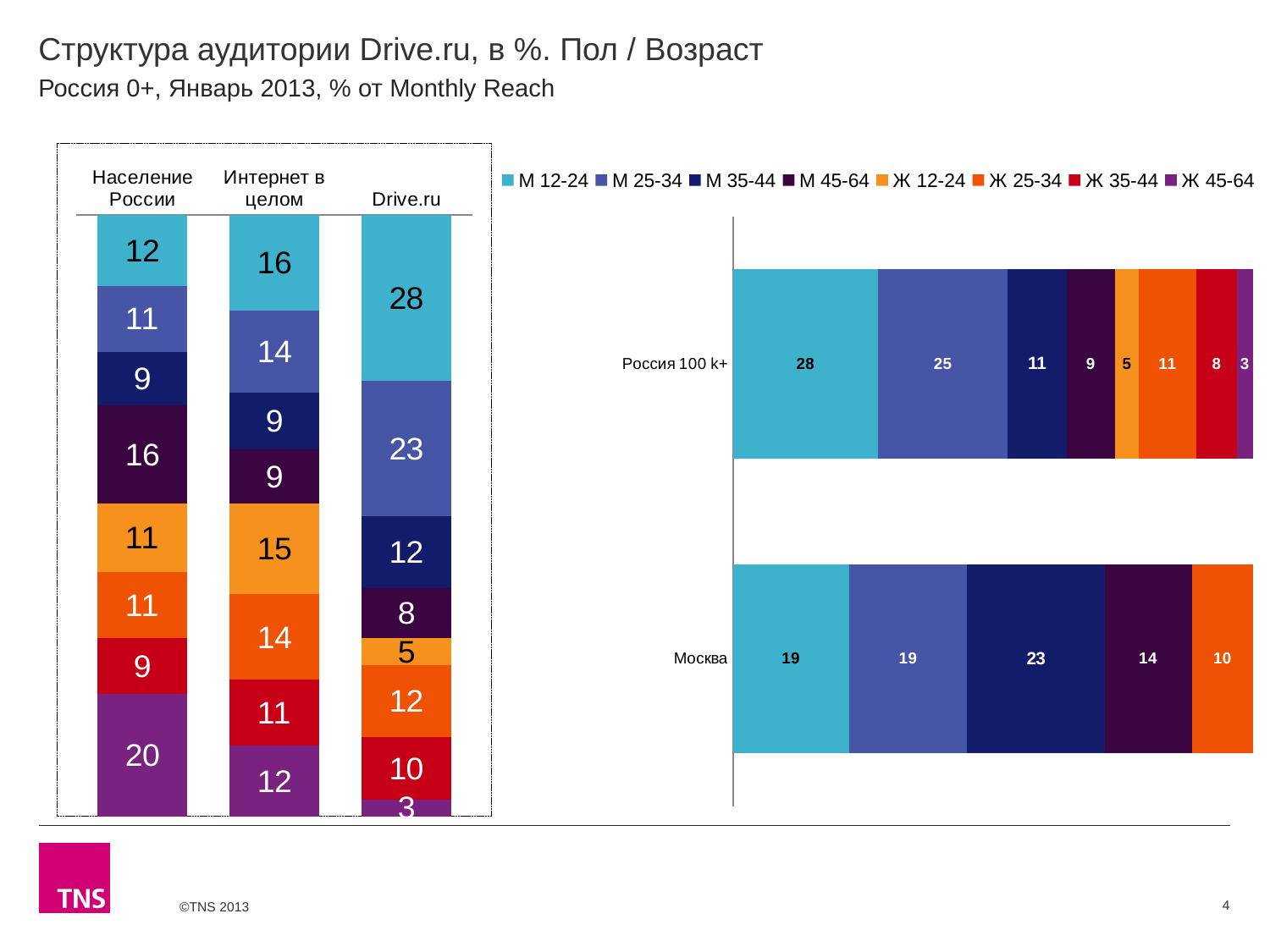
In the left chart, what is the difference between the М 12-24 values for Drive.ru and Население России? 16 In the left chart, which segment is the largest in the Drive.ru bar? М 12-24 How many series does the legend list? 8 In the right chart, what is the value of the М 35-44 segment for Москва? 23 What type of chart is the right chart? Stacked bar chart In the left chart, what is the value of the Ж 45-64 segment for Население России? 20 In the left chart, which segment is the smallest in the Drive.ru bar? Ж 45-64 In the left chart, what is the value of the М 12-24 segment for Drive.ru? 28 In the right chart, which is larger for Россия 100 k+: the М 35-44 segment or the Ж 35-44 segment? М 35-44 In the left chart, what is the value of the Ж 12-24 segment for Интернет в целом? 15 In the right chart, what is the value of the М 25-34 segment for Россия 100 k+? 25 In the left chart, how many bars are shown? 3